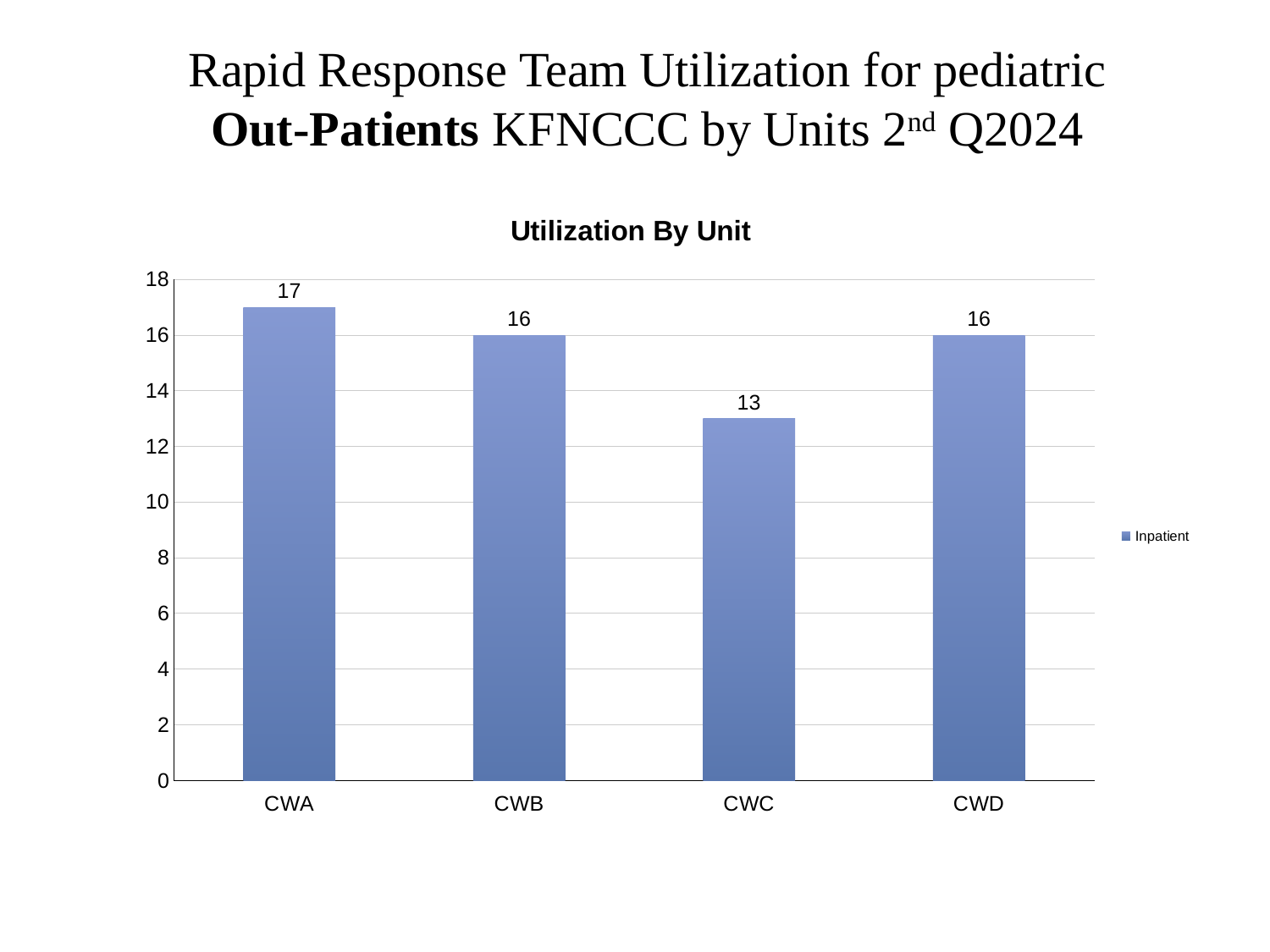
Which unit has the highest value? CWA Is the value for CWC greater or less than 14? less How many units are shown on the x axis? 4 What is the value for CWD? 16 Which is larger, the value for CWB or the value for CWC? CWB What is the title of the chart? Utilization By Unit Which unit has the lowest value? CWC What kind of chart is shown? bar chart What is the value for CWA? 17 How many series does the legend list? 1 What is the value for CWC? 13 What is the difference between the values for CWA and CWC? 4